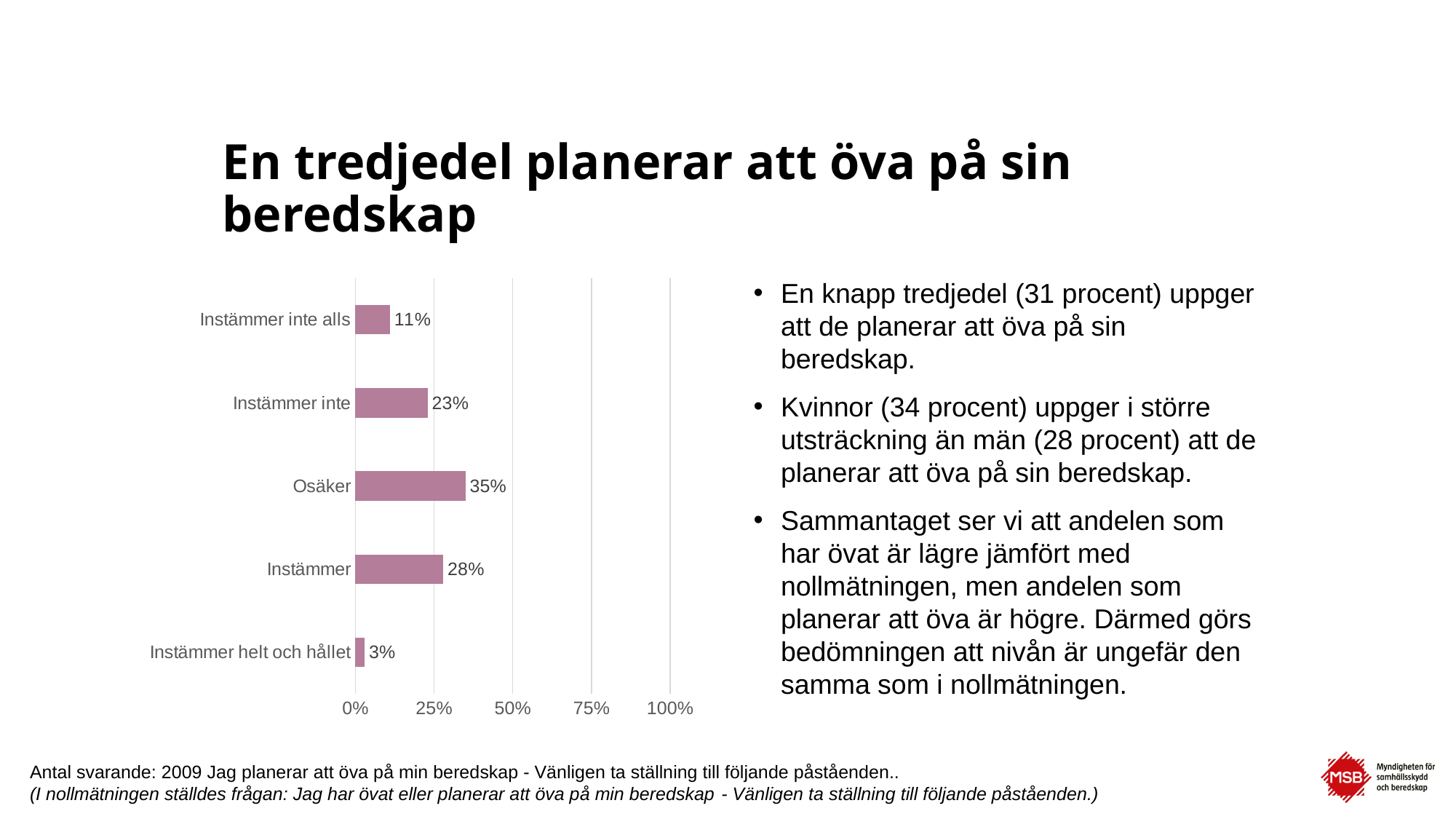
What is the difference between the values for "Osäker" and "Instämmer"? 7% Which is larger, the value for "Instämmer inte" or the value for "Instämmer"? Instämmer What is the value for "Instämmer inte"? 23% What is the value for "Osäker"? 35% What kind of chart is shown on the slide? bar chart Is the value for "Osäker" greater or less than 25%? greater What is the value for "Instämmer inte alls"? 11% How many categories are shown in the chart? 5 Which category has the highest value? Osäker What is the value for "Instämmer helt och hållet"? 3% Which category has the lowest value? Instämmer helt och hållet What is the combined value of "Instämmer" and "Instämmer helt och hållet"? 31%